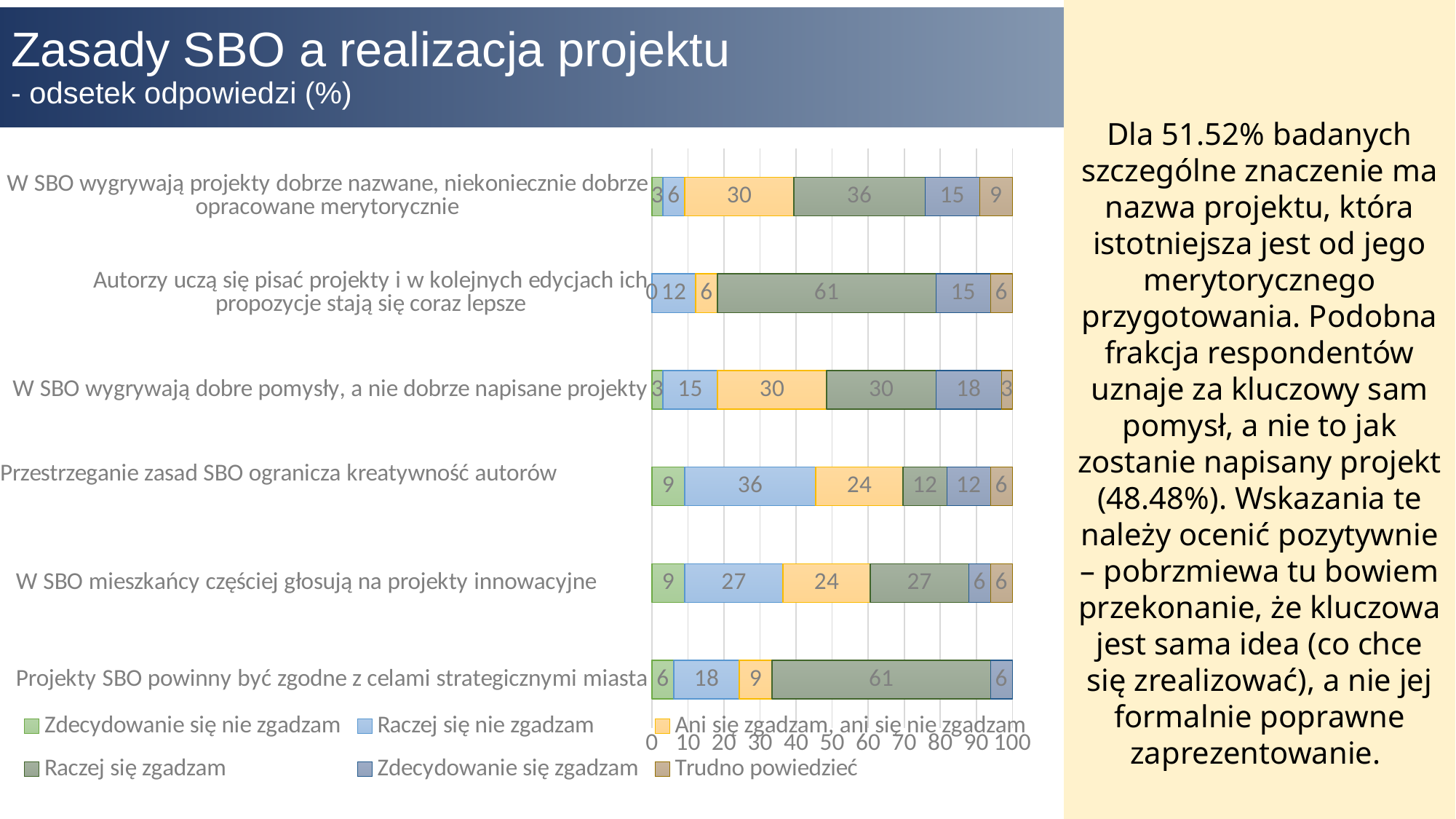
How many statements (categories) are plotted in the chart? 6 What is the value of 'Raczej się nie zgadzam' for 'Przestrzeganie zasad SBO ogranicza kreatywność autorów'? 36 What is the value of 'Raczej się zgadzam' for 'Autorzy uczą się pisać projekty i w kolejnych edycjach ich propozycje stają się coraz lepsze'? 61 Which is larger: 'Zdecydowanie się zgadzam' for 'W SBO wygrywają dobre pomysły, a nie dobrze napisane projekty' or for 'W SBO mieszkańcy częściej głosują na projekty innowacyjne'? W SBO wygrywają dobre pomysły, a nie dobrze napisane projekty Which statement has the highest 'Raczej się nie zgadzam' value? Przestrzeganie zasad SBO ogranicza kreatywność autorów What kind of chart is shown on the slide? Stacked bar chart What is the value of 'Ani się zgadzam, ani się nie zgadzam' for 'W SBO wygrywają dobre pomysły, a nie dobrze napisane projekty'? 30 How many series does the legend list? 6 What is the total of the stacked bar for 'Przestrzeganie zasad SBO ogranicza kreatywność autorów'? 99 What is the subtitle of the chart slide? - odsetek odpowiedzi (%) What is the difference between the 'Raczej się zgadzam' values for 'Projekty SBO powinny być zgodne z celami strategicznymi miasta' and 'W SBO mieszkańcy częściej głosują na projekty innowacyjne'? 34 What is the value of 'Trudno powiedzieć' for 'W SBO wygrywają projekty dobrze nazwane, niekoniecznie dobrze opracowane merytorycznie'? 9